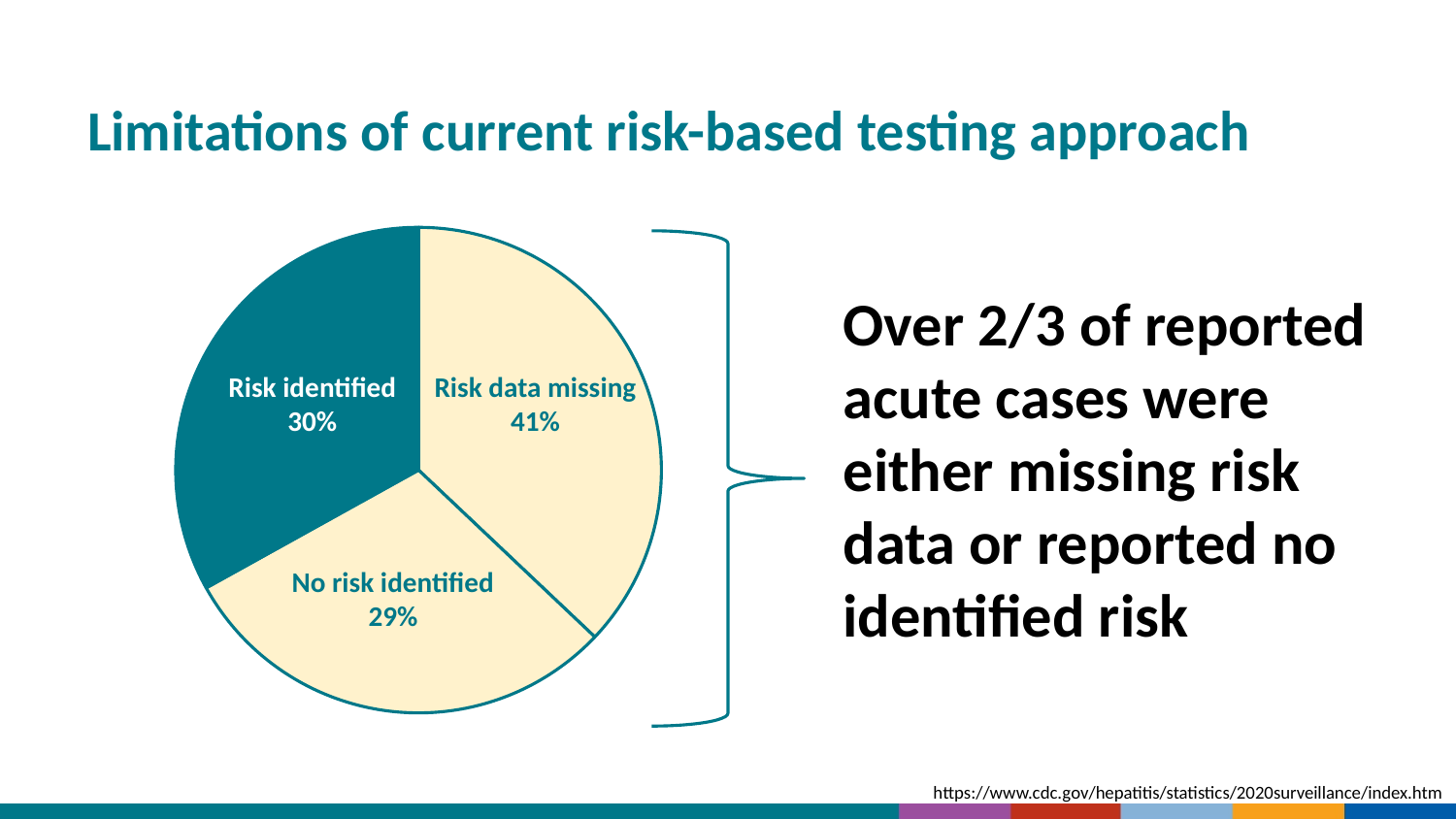
Which slice of the pie is coloured dark teal? Risk identified What percentage of cases had no risk identified? 29% Which is larger, 'Risk identified' or 'Risk data missing'? Risk data missing Which slice of the pie is the largest? Risk data missing What kind of chart is shown on the slide? pie chart What is the difference in percentage points between 'Risk data missing' and 'Risk identified'? 11 What is the title of the slide containing the pie chart? Limitations of current risk-based testing approach What percentage of cases had a risk identified? 30% What is the combined share of 'Risk data missing' and 'No risk identified'? 70% How many slices does the pie chart have? 3 Which slice of the pie is the smallest? No risk identified What percentage of cases had risk data missing? 41%